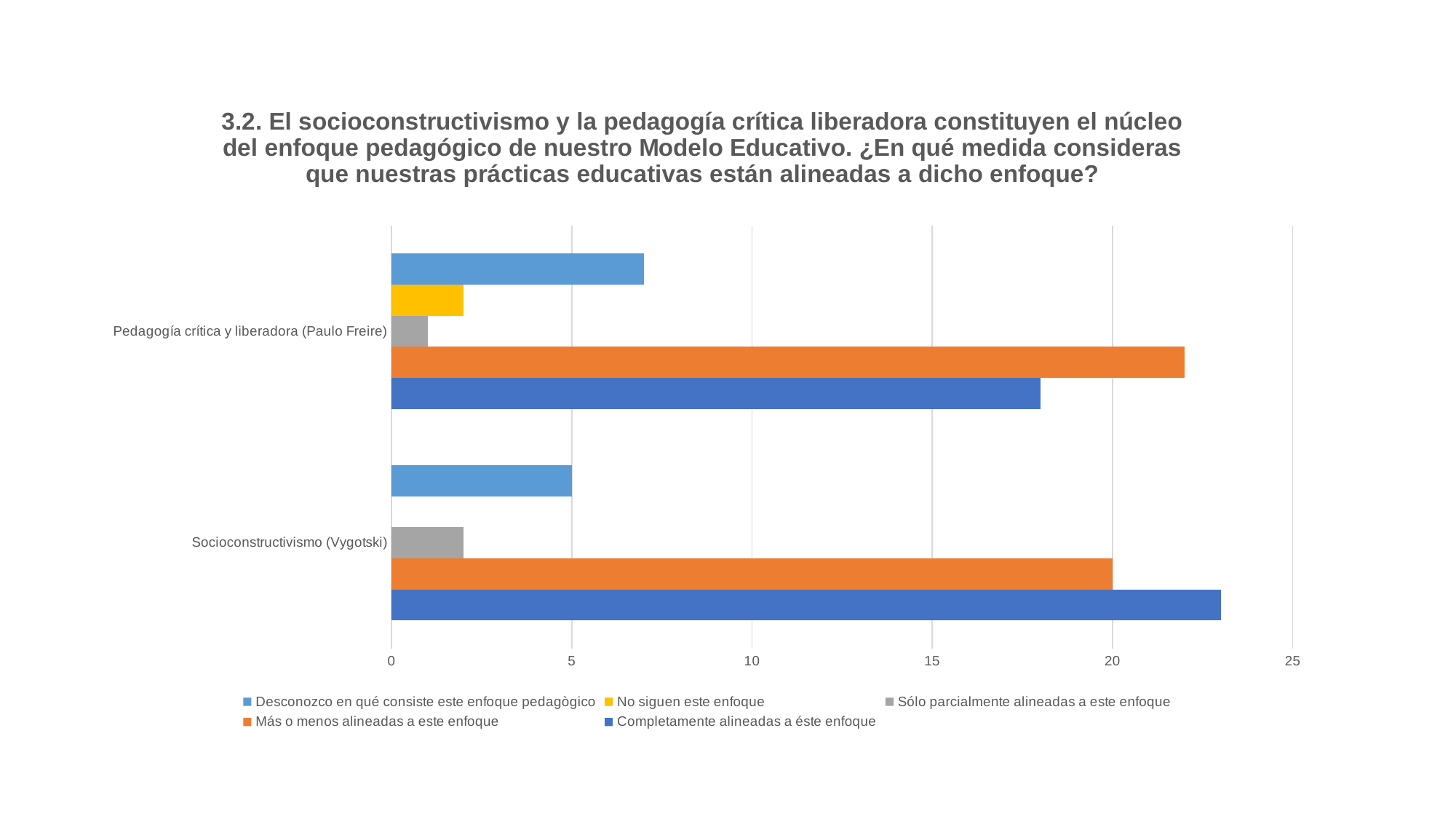
How many series does the legend list? 5 Which series has the highest value in the Pedagogía crítica y liberadora (Paulo Freire) category? Más o menos alineadas a este enfoque What is the value for "Desconozco en qué consiste este enfoque pedagògico" in the Socioconstructivismo (Vygotski) category? 5 Is the value for "Completamente alineadas a éste enfoque" in the Socioconstructivismo (Vygotski) category greater or less than 20? greater How many categories are shown on the vertical axis? 2 What kind of chart is shown on the slide? bar chart Is the value for "Completamente alineadas a éste enfoque" in the Pedagogía crítica y liberadora (Paulo Freire) category greater or less than 20? less What is the value for "Más o menos alineadas a este enfoque" in the Socioconstructivismo (Vygotski) category? 20 Which series has the lowest value in the Pedagogía crítica y liberadora (Paulo Freire) category? Sólo parcialmente alineadas a este enfoque Which series has the highest value in the Socioconstructivismo (Vygotski) category? Completamente alineadas a éste enfoque Which category has the larger value for "Completamente alineadas a éste enfoque"? Socioconstructivismo (Vygotski) Is the value for "Más o menos alineadas a este enfoque" in the Pedagogía crítica y liberadora (Paulo Freire) category greater or less than 20? greater